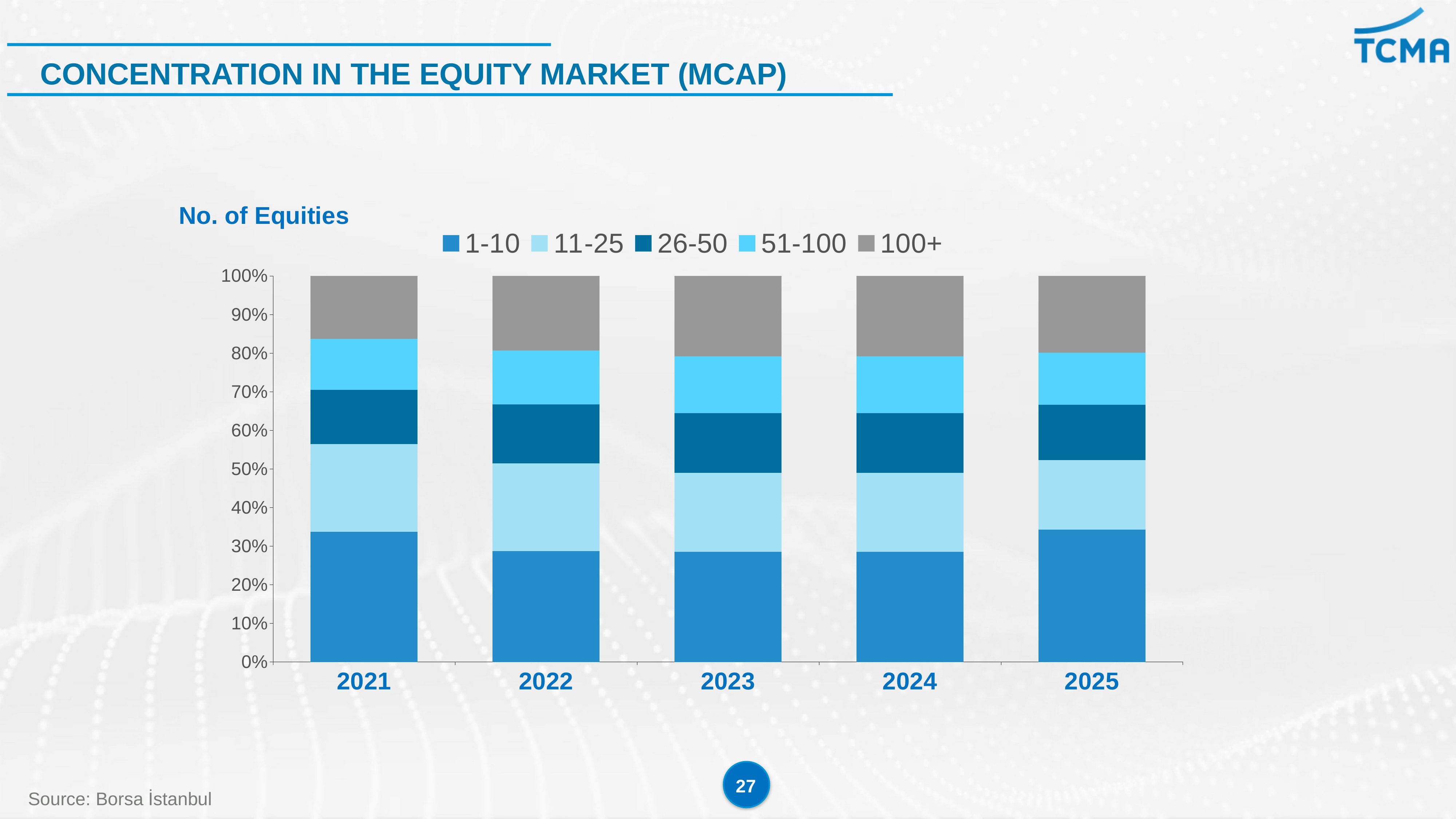
How many series does the chart legend list? 5 Is the share of the 1-10 group in 2022 greater or less than 40%? less Is the share of the 1-10 group in 2021 greater or less than 30%? greater How many years are shown on the x axis of the chart? 5 Is the share of the 1-10 group in 2025 greater or less than 30%? greater Which legend entry is shown in grey? 100+ In which year is the share of the 100+ group the smallest? 2021 What is the title shown above the chart? No. of Equities Which is larger, the share of the 1-10 group in 2021 or in 2022? 2021 What kind of chart is shown on the slide? Stacked bar chart What does each stacked bar total on the y axis? 100%